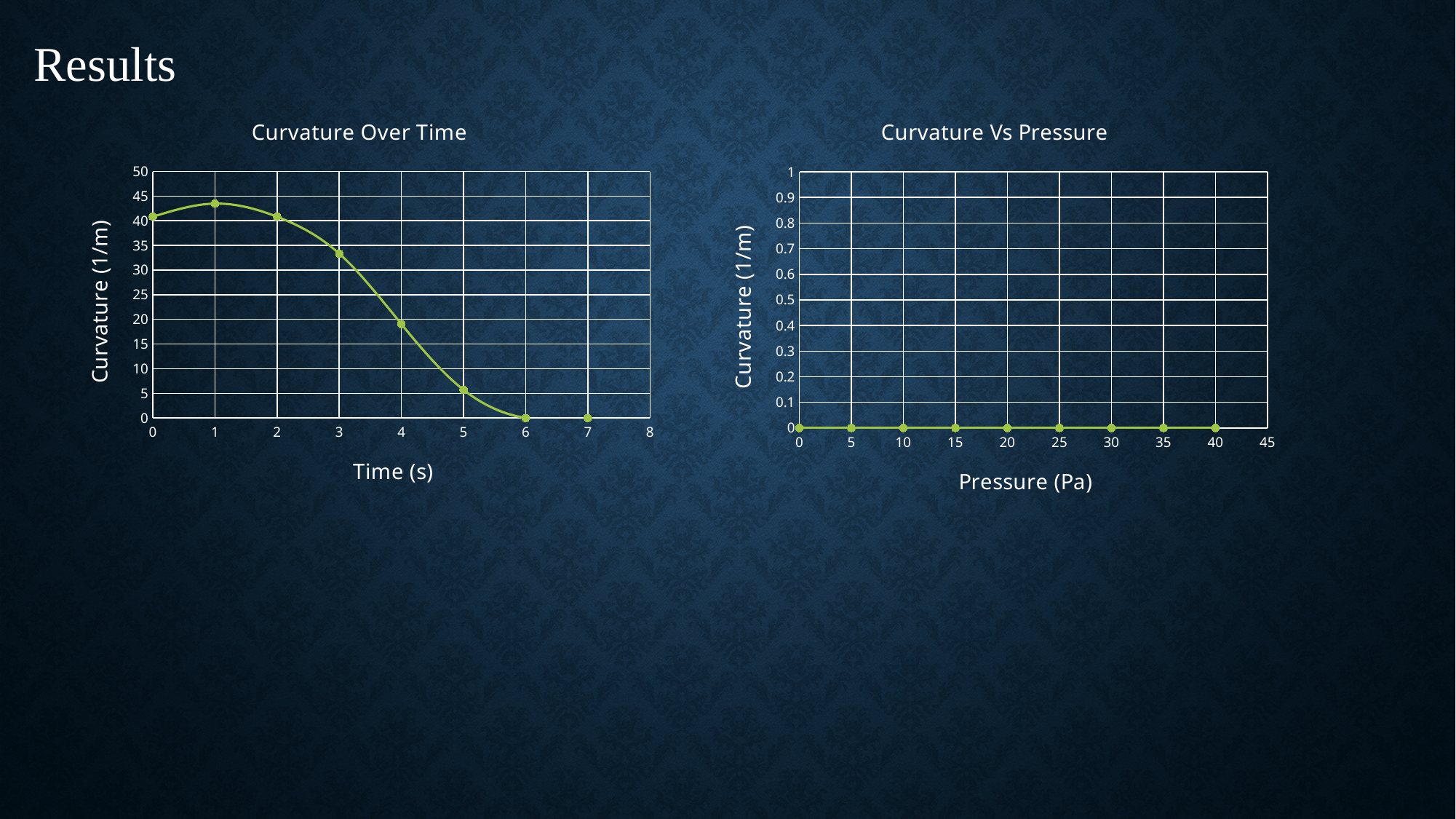
In the "Curvature Over Time" chart, is the curvature at 4 s greater or less than 25? less In the "Curvature Over Time" chart, what is the curvature at 6 s? 0 In the "Curvature Vs Pressure" chart, what is the curvature at 20 Pa? 0 In the "Curvature Over Time" chart, does the curvature rise or fall between 2 s and 6 s? fall In the "Curvature Over Time" chart, at which time is the curvature highest? 1 What type of chart is "Curvature Over Time"? line chart In the "Curvature Vs Pressure" chart, how many data points are plotted? 9 In the "Curvature Over Time" chart, is the curvature at 3 s greater or less than 30? greater In the "Curvature Over Time" chart, is the curvature at 5 s greater or less than 10? less In the "Curvature Over Time" chart, what is the curvature at 7 s? 0 In the "Curvature Over Time" chart, how many data points are plotted? 8 In the "Curvature Over Time" chart, which is larger, the curvature at 2 s or at 5 s? 2 s